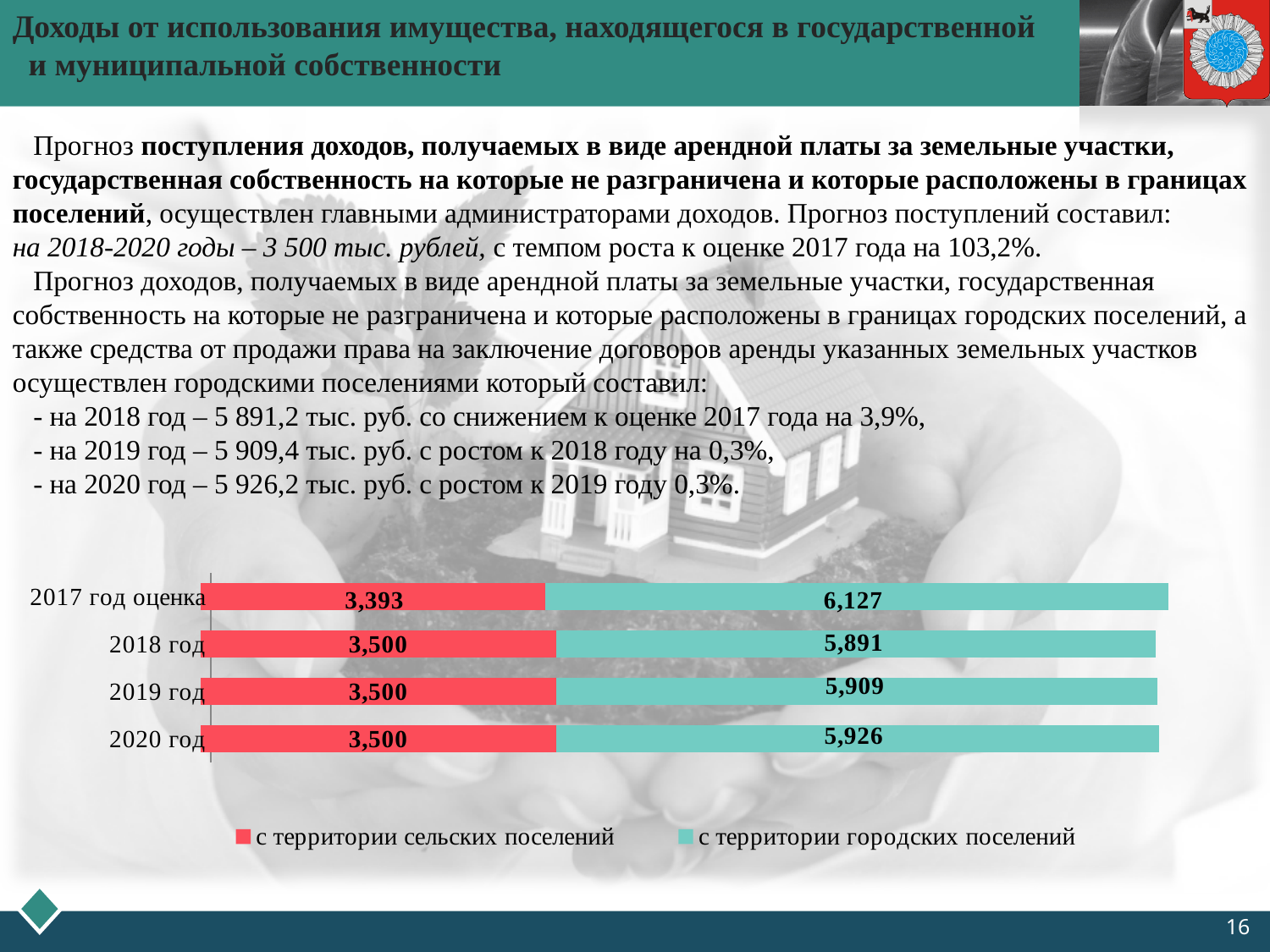
Which is larger in 2018 год: the value for 'с территории сельских поселений' or 'с территории городских поселений'? с территории городских поселений What is the difference between the 'городских поселений' and 'сельских поселений' values in 2017 год оценка? 2,734 What is the value for 'с территории городских поселений' in 2019 год? 5,909 Which year has the lowest value for 'с территории сельских поселений'? 2017 год оценка What is the total of the stacked bar for 2020 год? 9,426 What is the value for 'с территории сельских поселений' in 2017 год оценка? 3,393 How many categories (years) are shown on the chart? 4 What kind of chart is shown on the slide? stacked bar chart Which series is shown in red on the chart? с территории сельских поселений What is the value for 'с территории городских поселений' in 2020 год? 5,926 How many series does the chart legend list? 2 Which year has the highest value for 'с территории городских поселений'? 2017 год оценка